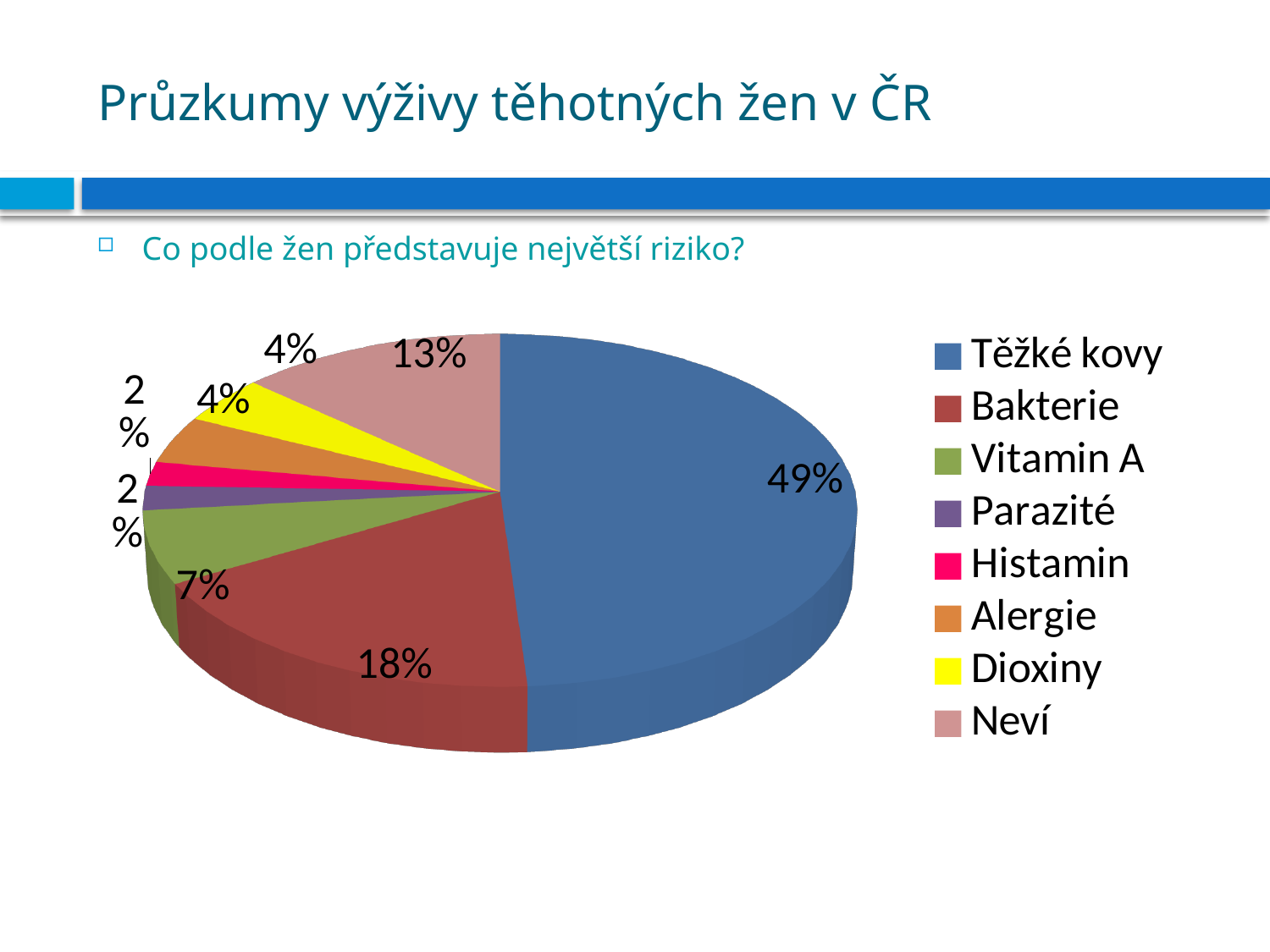
What share of the pie is labelled for Těžké kovy? 49% Which category has the largest slice of the pie? Těžké kovy What share of the pie is labelled for Vitamin A? 7% What kind of chart is shown on the slide? pie chart What share of the pie is labelled for Dioxiny? 4% What is the difference in percentage points between Těžké kovy and Bakterie? 31 What colour is the slice for Dioxiny? yellow What is the combined share of Bakterie and Neví? 31% How many categories does the legend list? 8 Which is larger, the slice for Neví or the slice for Vitamin A? Neví